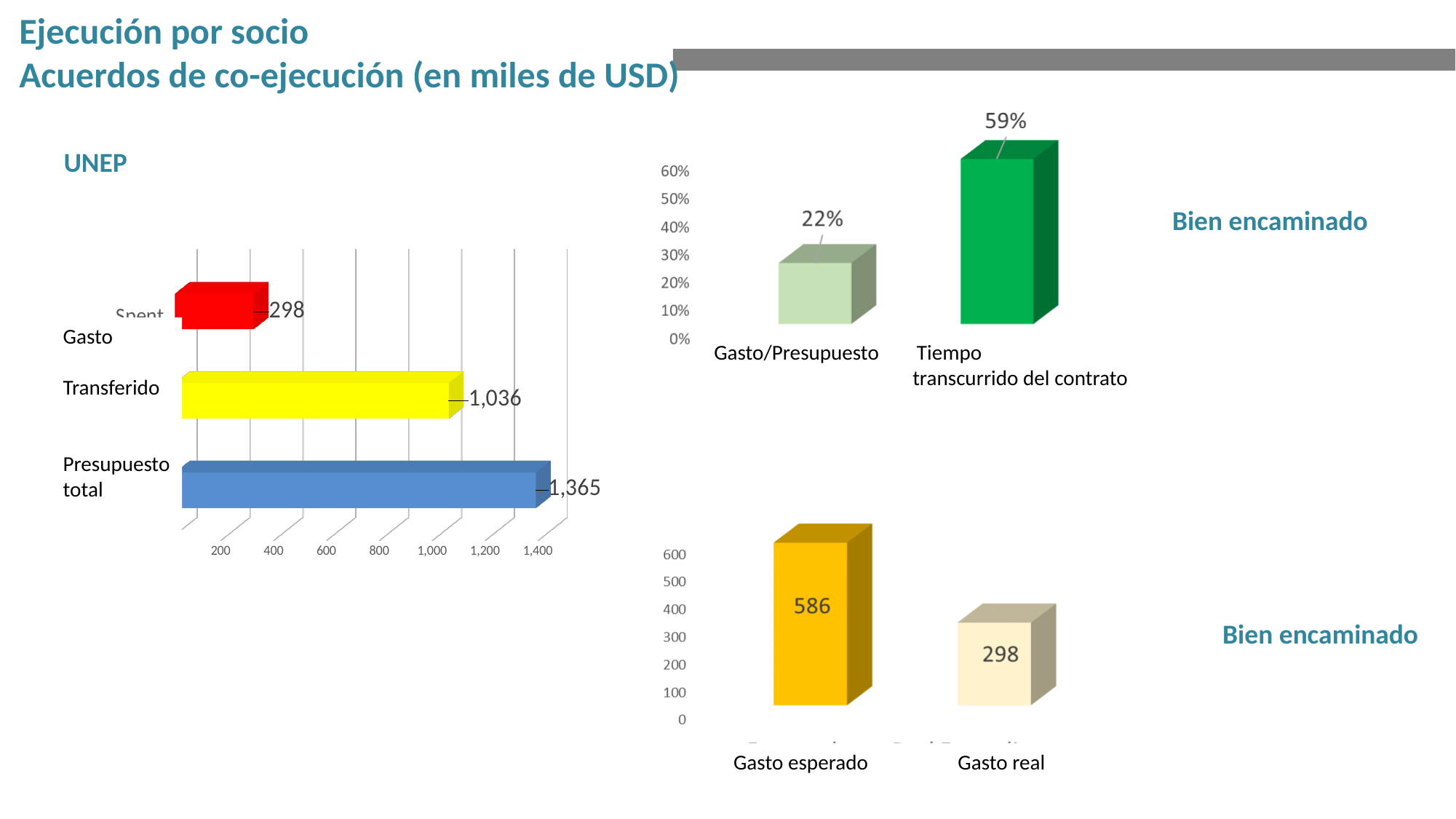
In the UNEP chart on the left, which category has the lowest value? Gasto In the chart at the bottom right, what is the value for Gasto esperado? 586 In the percentage chart at the top right, what is the value for Tiempo transcurrido del contrato? 59% In the UNEP chart on the left, how many categories are shown? 3 In the UNEP chart on the left, what is the value for Gasto? 298 In the percentage chart at the top right, what is the value for Gasto/Presupuesto? 22% In the UNEP chart on the left, what is the difference between Presupuesto total and Transferido? 329 In the UNEP chart on the left, what is the value for Transferido? 1,036 In the chart at the bottom right, what is the difference between Gasto esperado and Gasto real? 288 In the UNEP chart on the left, what is the value for Presupuesto total? 1,365 What kind of chart is the UNEP chart on the left? Bar chart In the percentage chart at the top right, which is larger, Gasto/Presupuesto or Tiempo transcurrido del contrato? Tiempo transcurrido del contrato